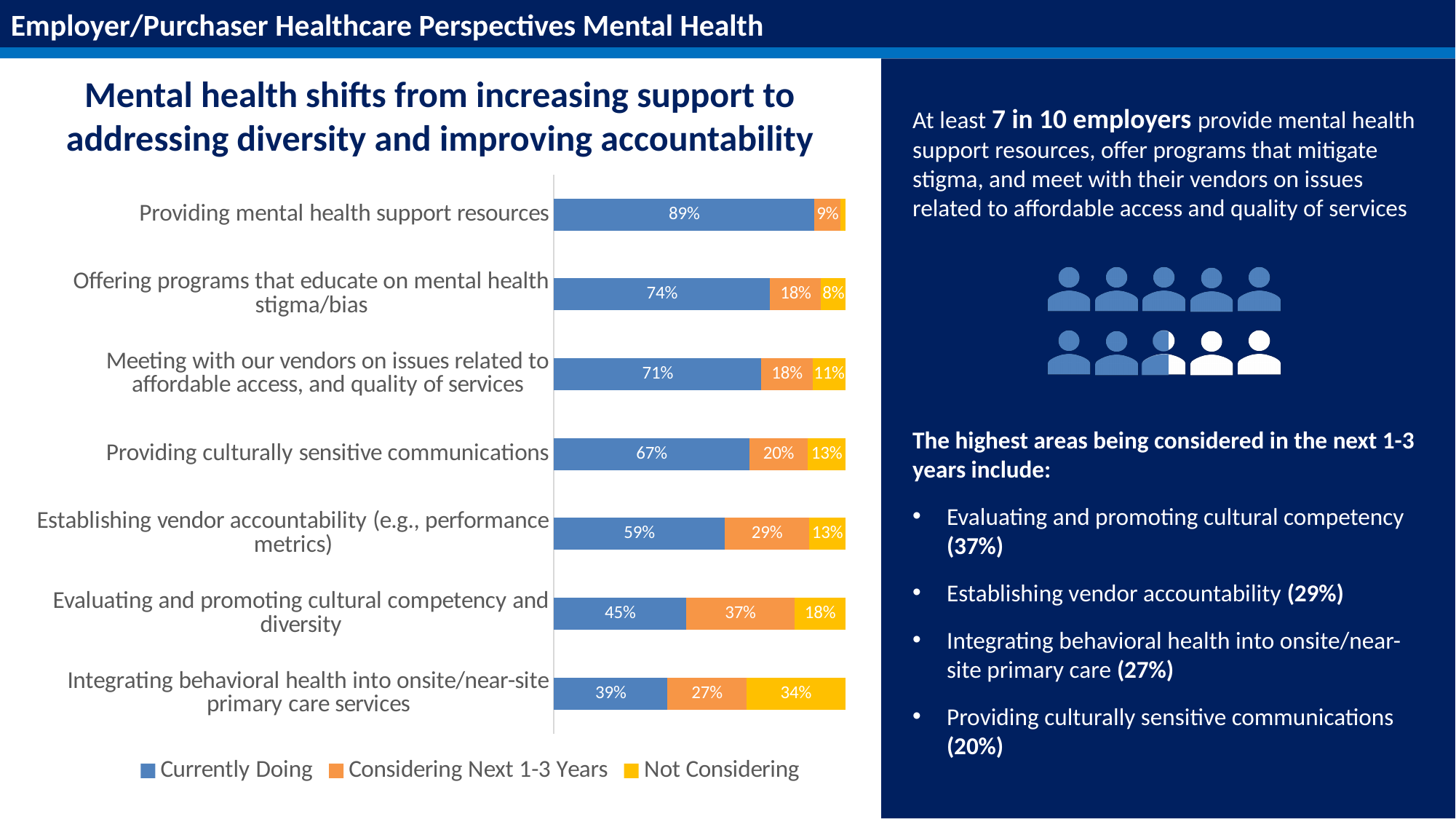
What is the 'Not Considering' value for 'Integrating behavioral health into onsite/near-site primary care services'? 34% How many categories are plotted in the chart? 7 What is the 'Currently Doing' value for 'Providing mental health support resources'? 89% How many series does the chart legend list? 3 What is the total of the stacked bar for 'Establishing vendor accountability (e.g., performance metrics)'? 101% Which category has the highest 'Considering Next 1-3 Years' value? Evaluating and promoting cultural competency and diversity Which category has the lowest 'Currently Doing' value? Integrating behavioral health into onsite/near-site primary care services What kind of chart is shown on the slide? Stacked bar chart What is the 'Considering Next 1-3 Years' value for 'Evaluating and promoting cultural competency and diversity'? 37% Which is larger: the 'Not Considering' value for 'Providing culturally sensitive communications' or for 'Offering programs that educate on mental health stigma/bias'? Providing culturally sensitive communications What is the difference between the 'Currently Doing' values for 'Offering programs that educate on mental health stigma/bias' and 'Meeting with our vendors on issues related to affordable access, and quality of services'? 3% Which colour represents the 'Not Considering' series in the chart? Yellow